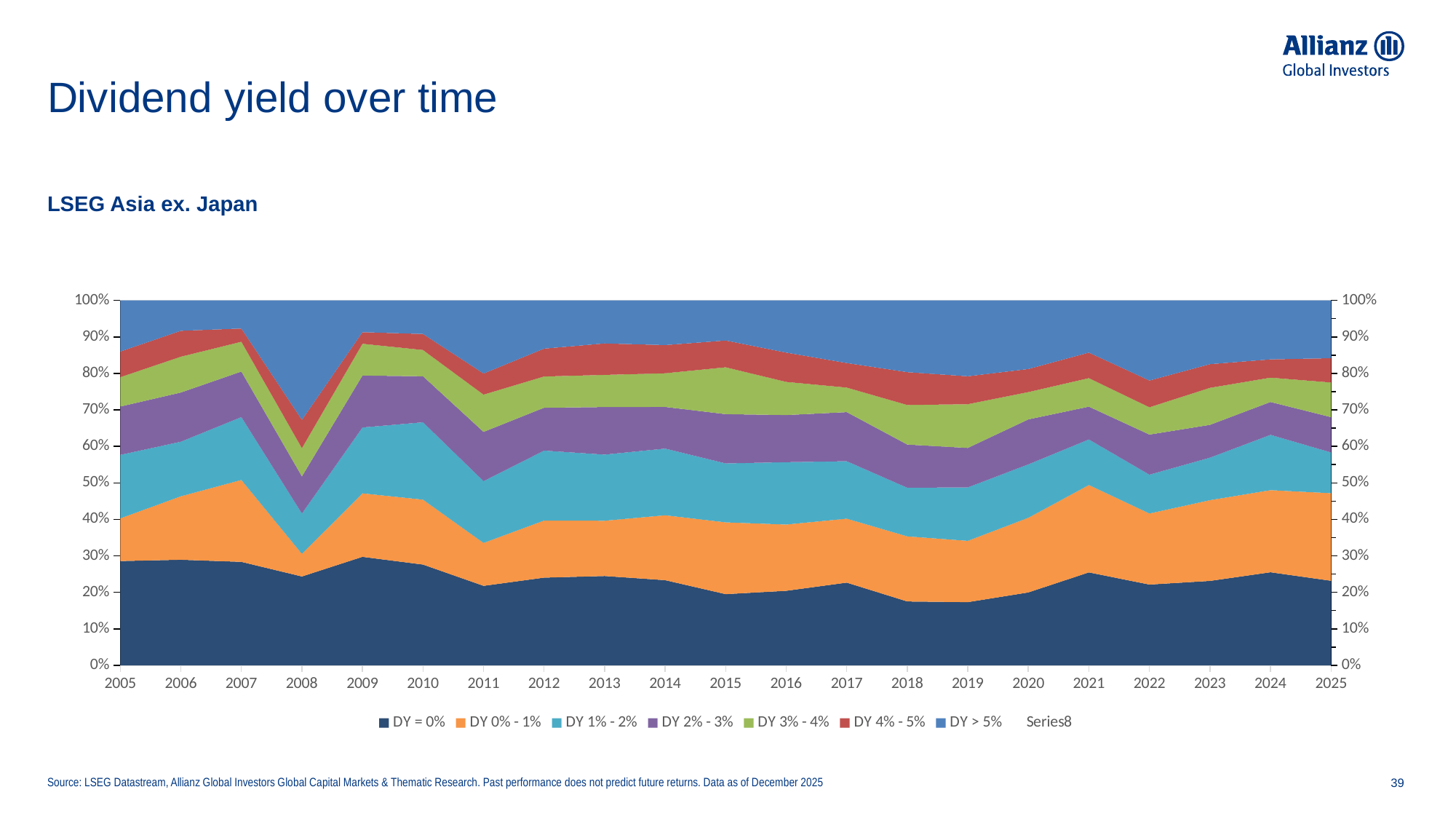
Is the value for DY = 0% in 2005 larger or smaller than in 2019? larger What kind of chart is shown on the slide? Stacked area chart What is the subtitle shown above the chart? LSEG Asia ex. Japan Is the value for DY = 0% in 2005 greater or less than 20%? greater Is the value for DY = 0% in 2021 greater or less than 30%? less Is the value for DY = 0% in 2019 greater or less than 20%? less How many series does the legend list? 8 How many years are plotted along the x axis? 21 What is the first year shown on the x axis? 2005 Does the DY = 0% series rise or fall from 2005 to 2008? fall